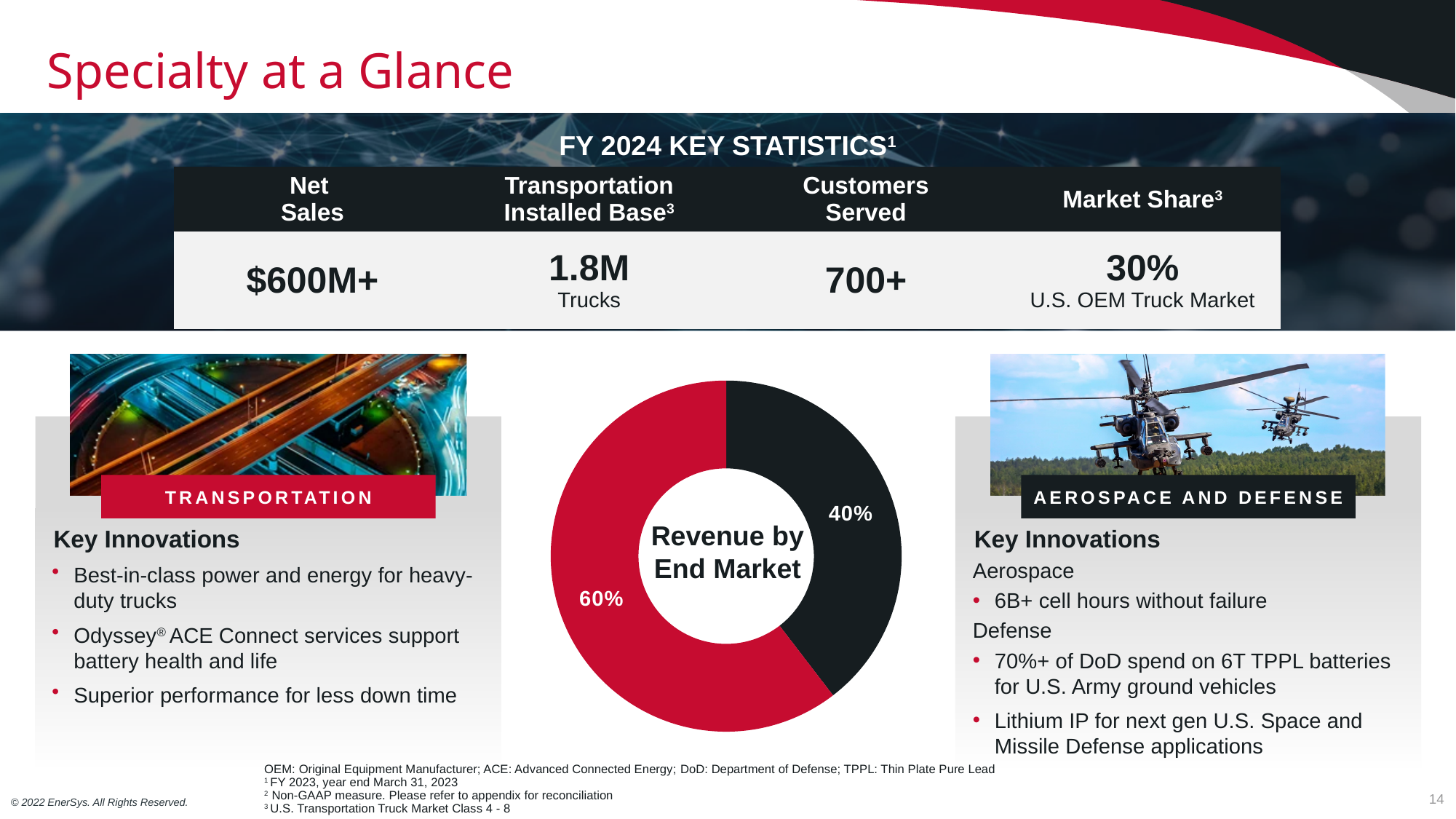
How many slices does the "Revenue by End Market" chart have? 2 In the "Revenue by End Market" chart, is the red slice greater or less than 50%? greater In the "Revenue by End Market" chart, which slice is the smallest? the black slice (40%) In the "Revenue by End Market" chart, which is larger, the red slice or the black slice? the red slice In the "Revenue by End Market" chart, which slice is the largest? the red slice (60%) In the "Revenue by End Market" chart, what is the difference between the red slice and the black slice? 20 percentage points In the "Revenue by End Market" chart, what percentage is shown for the black slice? 40% What kind of chart is the "Revenue by End Market" chart? pie chart (donut) In the "Revenue by End Market" chart, what percentage is shown for the red slice? 60% What colours are used for the two slices of the "Revenue by End Market" chart? red and black In the "Revenue by End Market" chart, what share of revenue does the black slice represent? 40% What is the title shown in the centre of the donut chart? Revenue by End Market